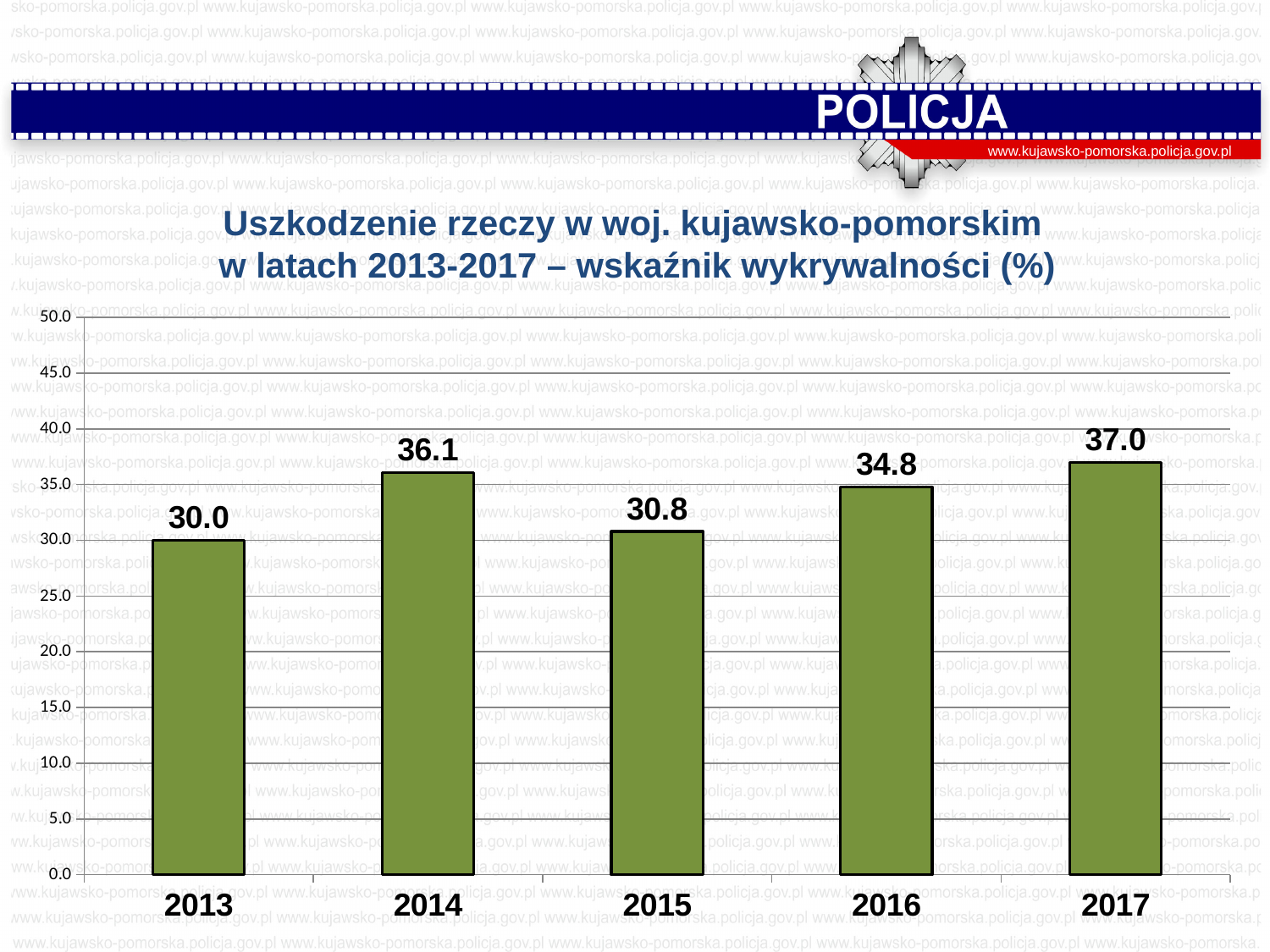
Which year has the lowest value? 2013 What is the value for 2017? 37.0 What is the value for 2014? 36.1 What is the value for 2013? 30.0 Which year has the highest value? 2017 What is the value for 2016? 34.8 What kind of chart is shown on the slide? bar chart How many years are shown on the x axis? 5 What is the difference between the values for 2017 and 2013? 7.0 What is the title of the chart? Uszkodzenie rzeczy w woj. kujawsko-pomorskim w latach 2013-2017 – wskaźnik wykrywalności (%) What is the value for 2015? 30.8 Which is larger, the value for 2014 or the value for 2016? 2014